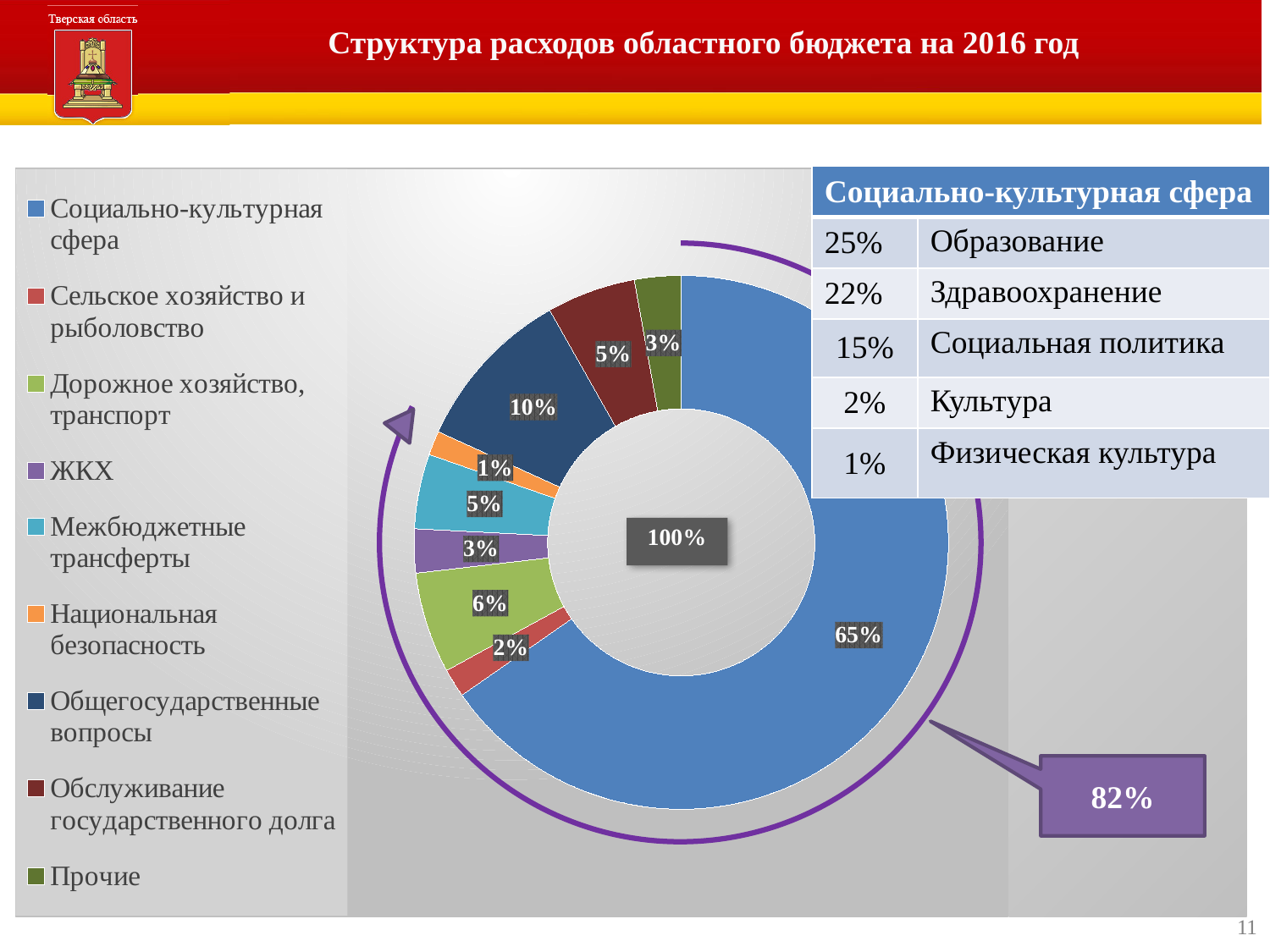
What share of expenditure is shown for Общегосударственные вопросы? 10% What share of expenditure is shown for Дорожное хозяйство, транспорт? 6% What is the title of the slide? Структура расходов областного бюджета на 2016 год What share of expenditure is shown for Национальная безопасность? 1% What is the difference in percentage points between Общегосударственные вопросы and Межбюджетные трансферты? 5 Which category has the smallest share of the budget expenditure? Национальная безопасность Which category has the largest share of the budget expenditure? Социально-культурная сфера What share of the regional budget expenditure goes to Социально-культурная сфера? 65% What kind of chart is shown on the slide? Pie (doughnut) chart How many expenditure categories does the legend list? 9 Which is larger: the share for ЖКХ or the share for Дорожное хозяйство, транспорт? Дорожное хозяйство, транспорт According to the table, what share of expenditure goes to Образование? 25%